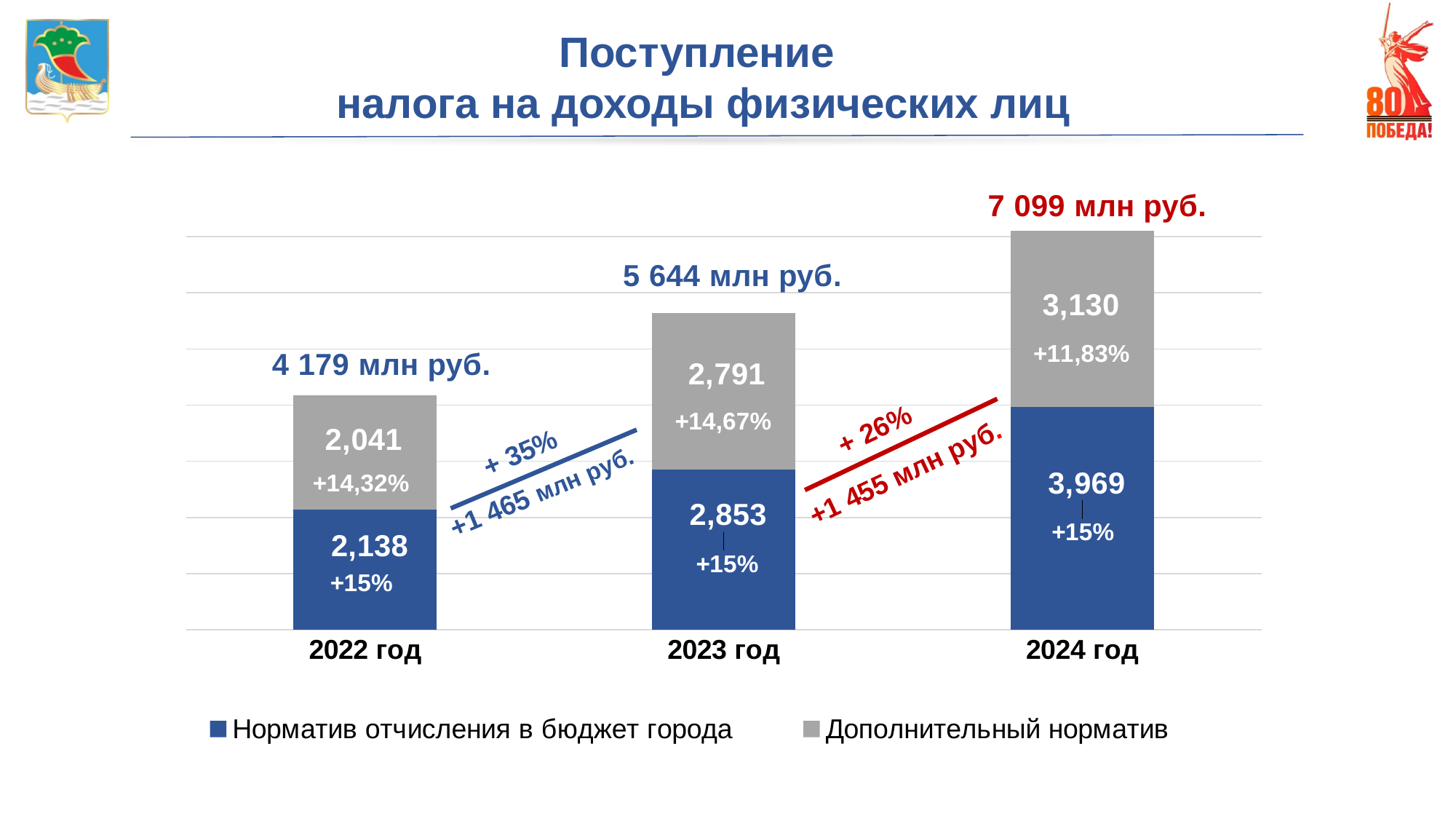
What type of chart is shown on the slide? Stacked bar chart What is the value of "Норматив отчисления в бюджет города" for 2022 год? 2,138 Which year has the lowest value for "Норматив отчисления в бюджет города"? 2022 год What is the value of "Норматив отчисления в бюджет города" for 2024 год? 3,969 How many series does the legend list? 2 What is the difference between the "Норматив отчисления в бюджет города" values for 2024 год and 2023 год? 1,116 What is the total shown above the bar for 2023 год? 5 644 млн руб. What is the value of "Дополнительный норматив" for 2023 год? 2,791 How many years are shown on the x axis? 3 Which year has the highest value for "Дополнительный норматив"? 2024 год What is the total shown above the bar for 2024 год? 7 099 млн руб. Which is larger in 2024 год: "Норматив отчисления в бюджет города" or "Дополнительный норматив"? Норматив отчисления в бюджет города